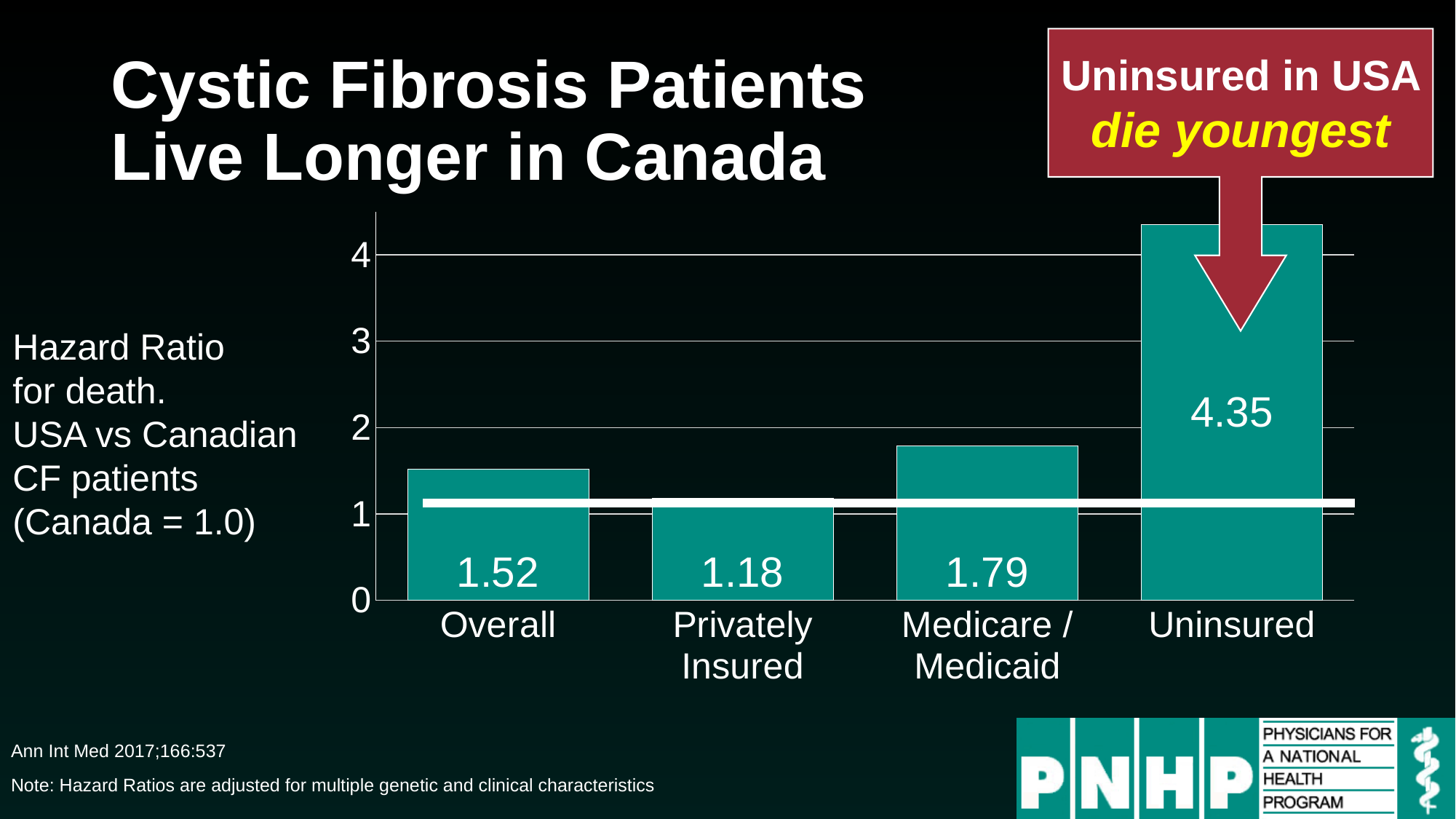
What is the hazard ratio for death for Uninsured patients? 4.35 What is the hazard ratio for death for Medicare / Medicaid patients? 1.79 Is the hazard ratio for Uninsured patients greater or less than 4? greater Which category has the lowest hazard ratio? Privately Insured Which category has the highest hazard ratio? Uninsured What is the difference between the hazard ratios for Medicare / Medicaid and Overall? 0.27 What kind of chart is shown on the slide? Bar chart Which is larger, the hazard ratio for Medicare / Medicaid or for Overall? Medicare / Medicaid What is the Overall hazard ratio for death? 1.52 How many categories are shown on the x axis of the chart? 4 What is the difference between the hazard ratios for Uninsured and Privately Insured patients? 3.17 What is the hazard ratio for death for Privately Insured patients? 1.18